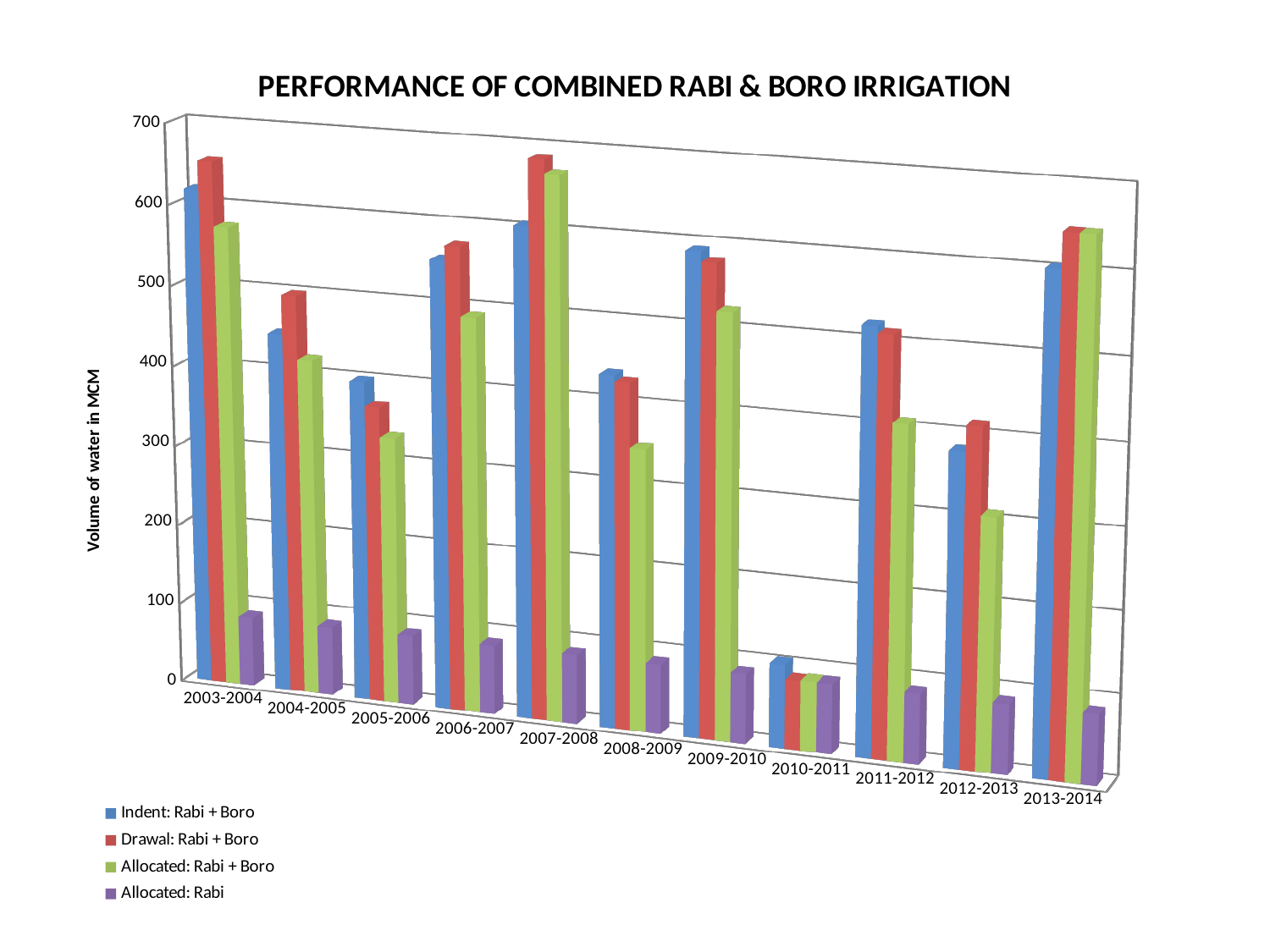
In 2012-2013, which is larger: Drawal: Rabi + Boro or Allocated: Rabi + Boro? Drawal: Rabi + Boro Is the value for Drawal: Rabi + Boro in 2007-2008 greater or less than 600? greater Which year has the highest value for Indent: Rabi + Boro? 2003-2004 Which year has the highest value for Allocated: Rabi + Boro? 2007-2008 How many year categories are shown on the x axis? 11 How many series does the legend list? 4 What kind of chart is shown on the slide? bar chart Which year has the lowest value for Indent: Rabi + Boro? 2010-2011 What is the label on the vertical axis? Volume of water in MCM